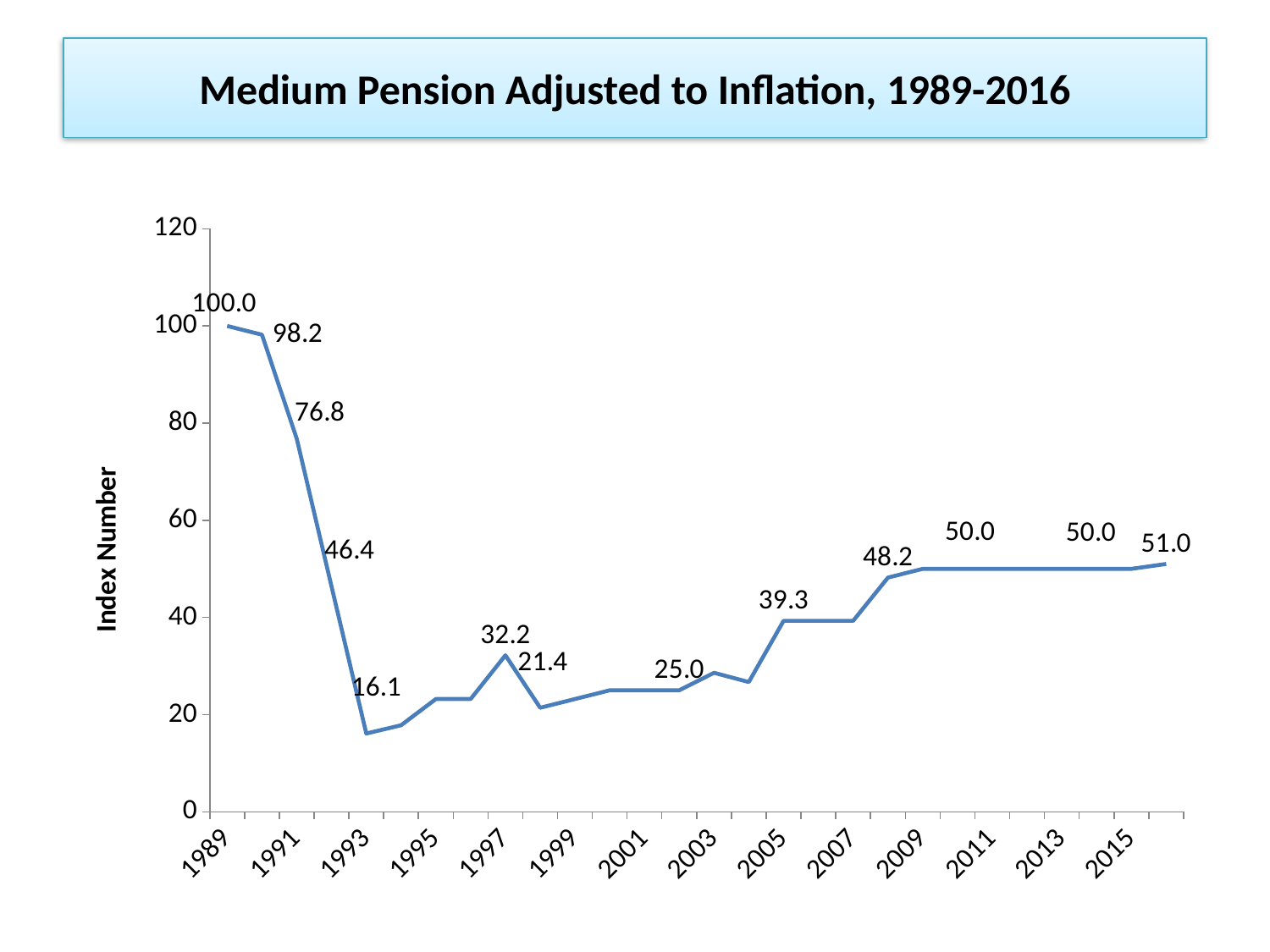
What is the index number for 1989? 100.0 Which year has the highest index number? 1989 What is the index number for 1997? 32.2 Does the index number rise or fall from 1989 to 1993? fall Which is larger, the index number for 1997 or for 2005? 2005 What is the index number for 2016? 51.0 Which year has the lowest index number? 1993 What type of chart is shown on the slide? line chart Is the index number for 2011 greater or less than 60? less What is the index number for 1993? 16.1 What is the difference between the index number in 1989 and in 1993? 83.9 What is the index number for 1991? 76.8